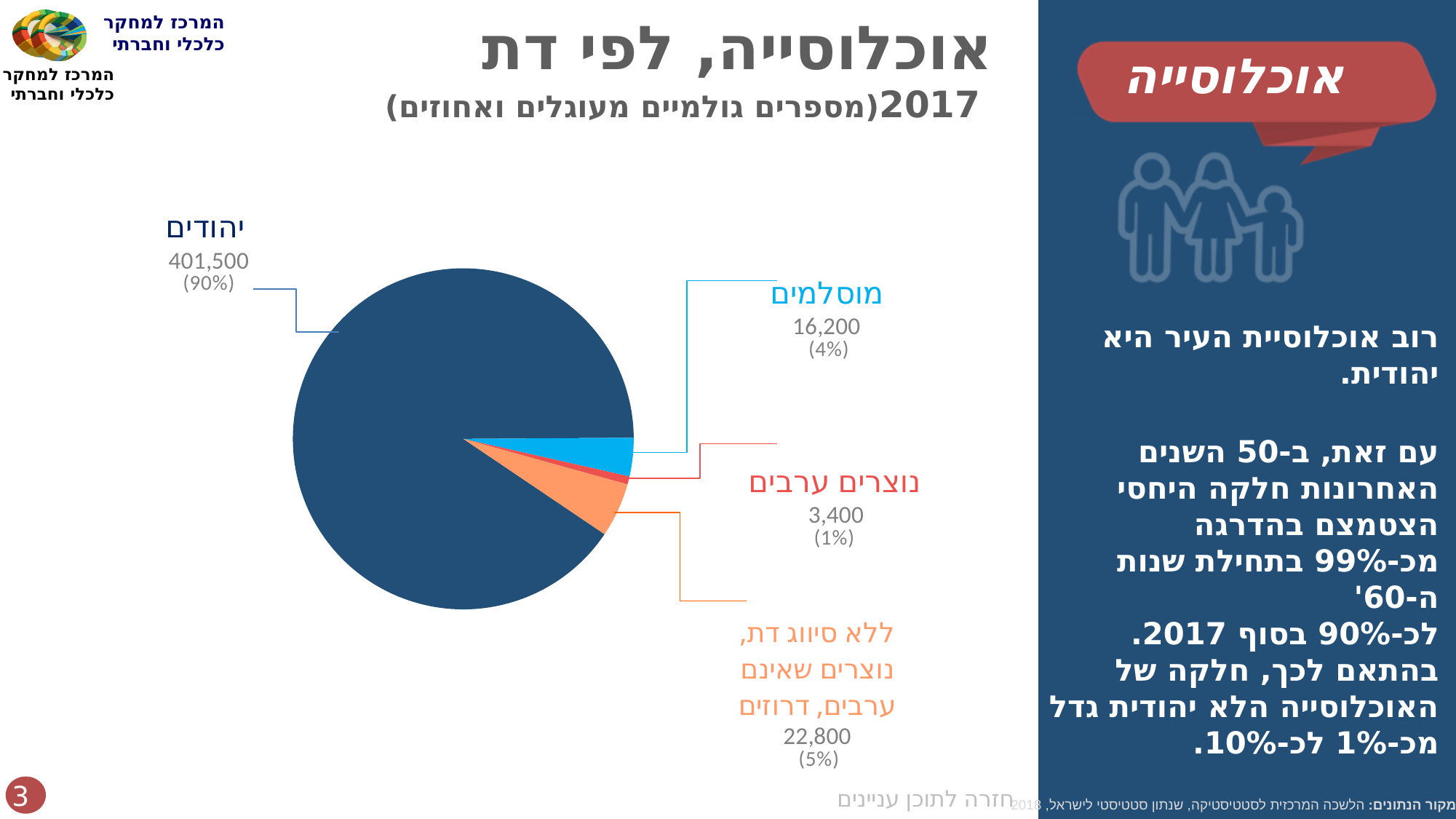
Which category has the smallest slice of the pie? נוצרים ערבים What is the value shown for מוסלמים (Muslims)? 16,200 What is the value shown for נוצרים ערבים (Arab Christians)? 3,400 What percentage share does the מוסלמים (Muslims) slice have? 4% What is the value shown for the slice labelled ללא סיווג דת, נוצרים שאינם ערבים, דרוזים? 22,800 What kind of chart is shown on the slide? Pie chart What percentage share does the יהודים (Jews) slice have? 90% How many slices does the pie chart have? 4 What is the difference between the values for מוסלמים and נוצרים ערבים? 12,800 Which category has the largest slice of the pie? יהודים Which is larger, the value for מוסלמים or the value for ללא סיווג דת, נוצרים שאינם ערבים, דרוזים? ללא סיווג דת, נוצרים שאינם ערבים, דרוזים What is the value shown for יהודים (Jews) in the pie chart? 401,500